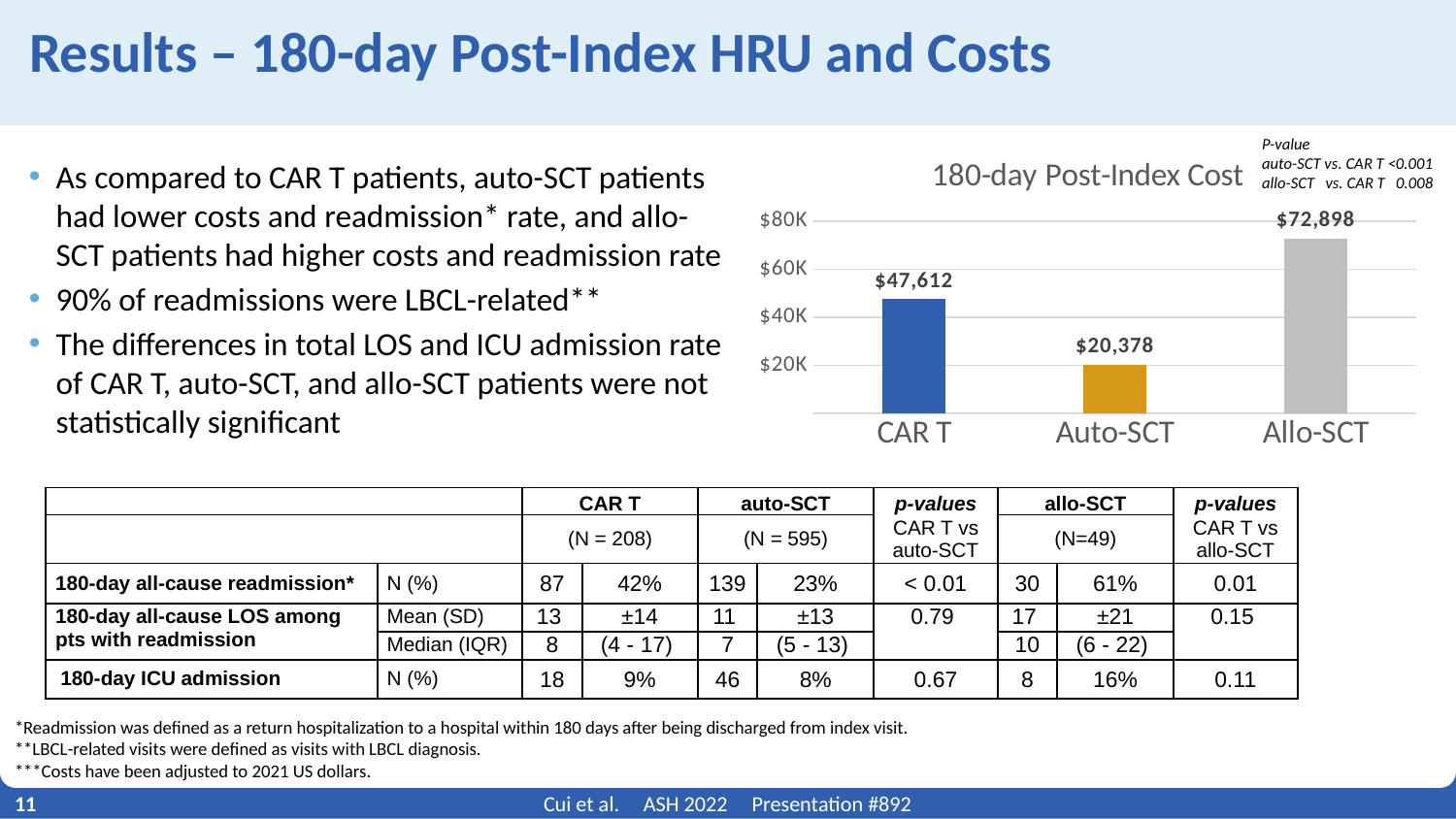
What is the title of the chart on the slide? 180-day Post-Index Cost What is the 180-day post-index cost for CAR T patients? $47,612 Is the 180-day post-index cost for Allo-SCT greater or less than $60K? greater Which has a higher 180-day post-index cost, CAR T or Auto-SCT? CAR T What is the difference in 180-day post-index cost between CAR T and Auto-SCT? $27,234 How many groups are shown in the 180-day Post-Index Cost chart? 3 What is the 180-day post-index cost for Allo-SCT patients? $72,898 What is the 180-day post-index cost for Auto-SCT patients? $20,378 What type of chart is used to show the 180-day post-index cost? Bar chart Which group has the lowest 180-day post-index cost? Auto-SCT What is the difference in 180-day post-index cost between Allo-SCT and CAR T? $25,286 Which group has the highest 180-day post-index cost? Allo-SCT